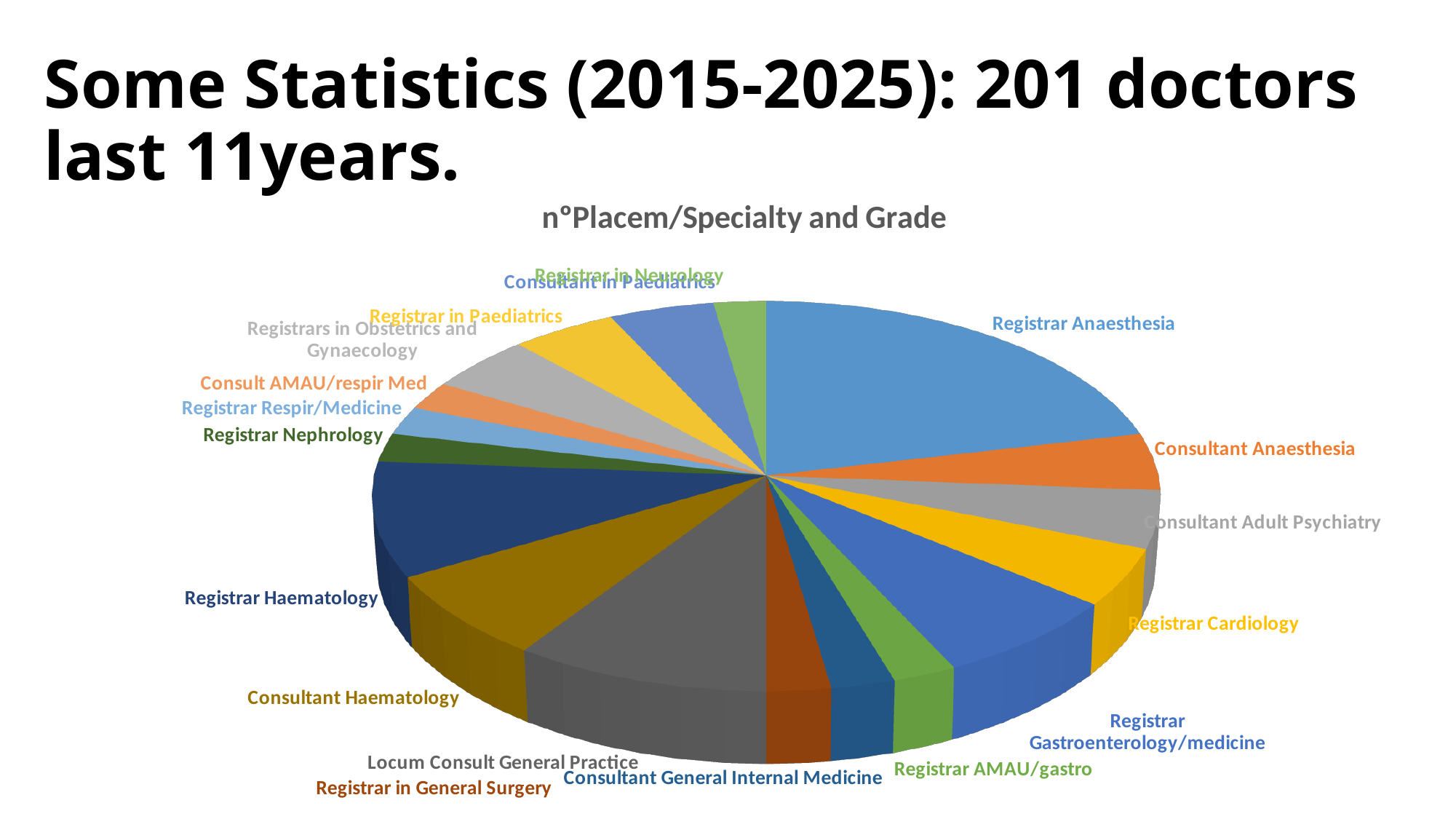
What colour is the slice for Registrar Anaesthesia? Blue Which is larger: the slice for Registrar Gastroenterology/medicine or the slice for Registrar in Neurology? Registrar Gastroenterology/medicine Which is larger: the slice for Locum Consult General Practice or the slice for Consultant Adult Psychiatry? Locum Consult General Practice Which is larger: the slice for Registrar Haematology or the slice for Registrar Respir/Medicine? Registrar Haematology What kind of chart is shown on the slide? Pie chart What is the title of the chart? n°Placem/Specialty and Grade Which category has the largest slice of the pie? Registrar Anaesthesia How many slices (categories) does the pie chart have? 18